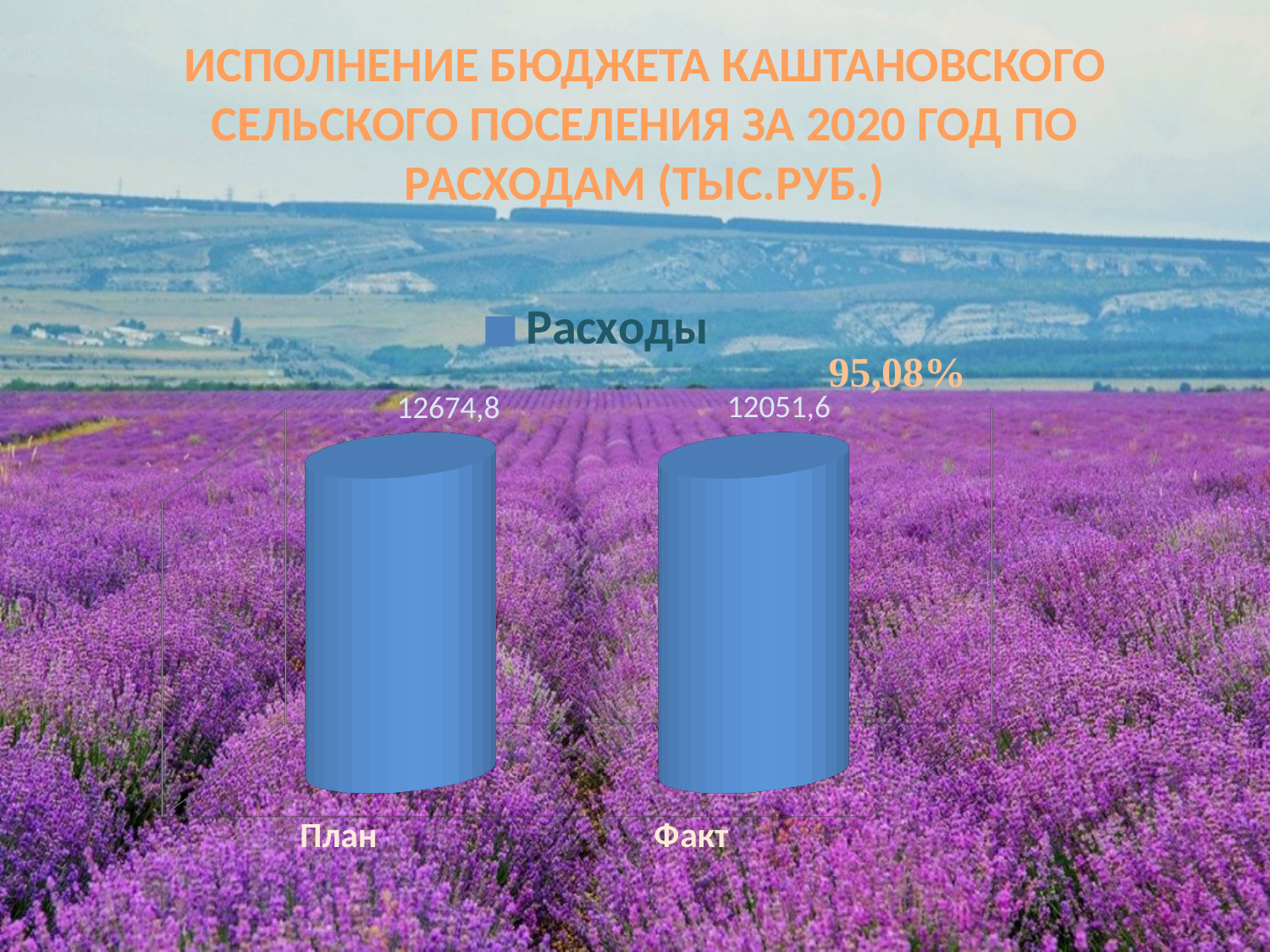
Which category has the highest value? План What is the value for План? 12674,8 What series name is shown in the chart legend? Расходы Do the values rise or fall from План to Факт? Fall What percentage is printed above the Факт bar? 95,08% What is the value for Факт? 12051,6 How many categories are shown on the chart? 2 What kind of chart is shown on the slide? Bar chart Which category has the higher value, План or Факт? План Which category has the lowest value? Факт How many series does the legend list? 1 What is the difference between the План and Факт values? 623,2